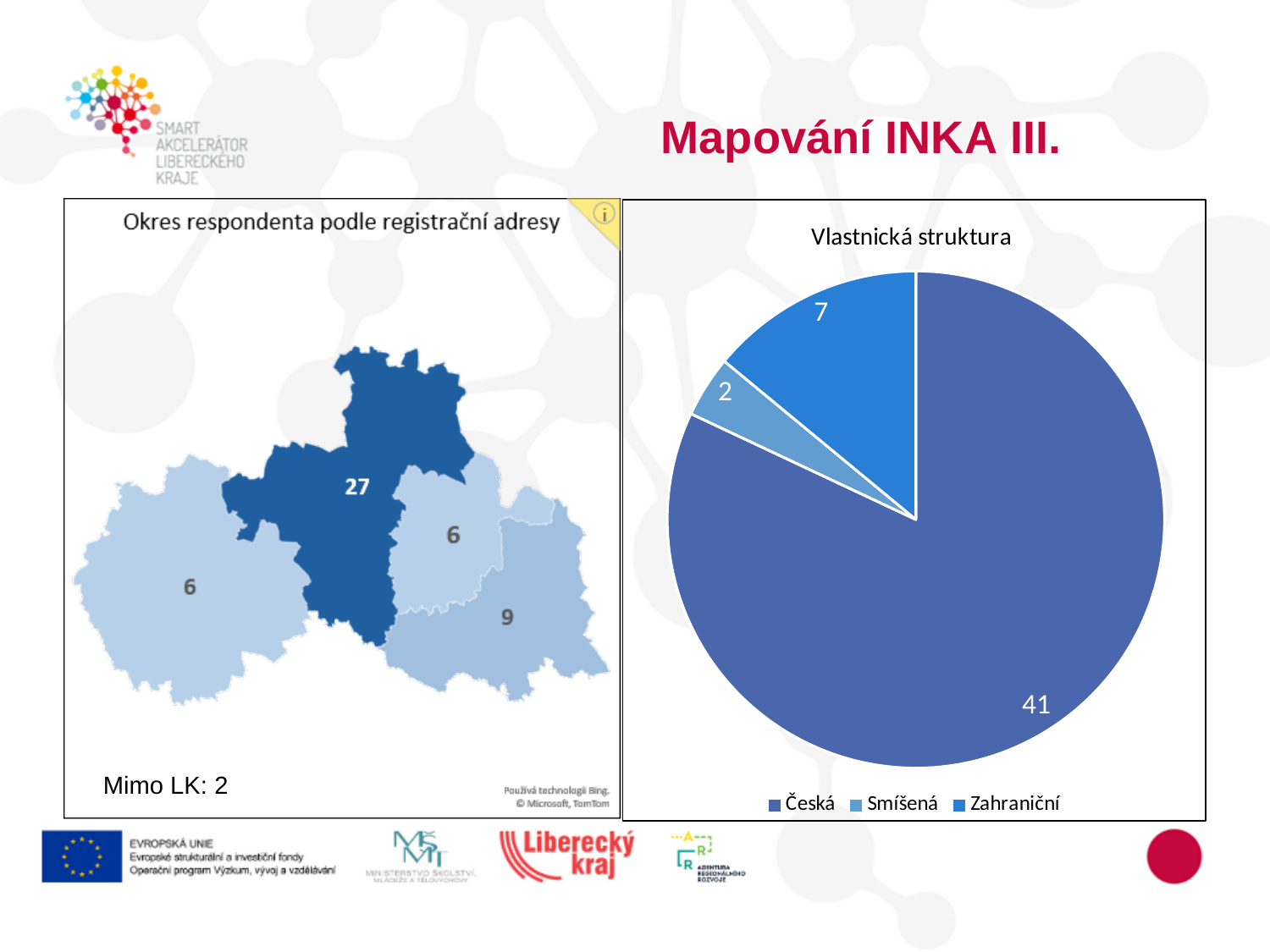
In the map chart 'Okres respondenta podle registrační adresy', what is the highest value shown for a district? 27 In the 'Vlastnická struktura' chart, what is the value for Smíšená? 2 In the 'Vlastnická struktura' chart, what is the difference between the values for Česká and Zahraniční? 34 In the 'Vlastnická struktura' chart, which category has the smallest slice? Smíšená In the 'Vlastnická struktura' chart, how many categories does the legend list? 3 In the 'Vlastnická struktura' chart, what is the value for Zahraniční? 7 In the 'Vlastnická struktura' chart, what share of the total does Česká represent? 82% In the map chart 'Okres respondenta podle registrační adresy', how many districts have a value label shown? 4 In the 'Vlastnická struktura' chart, what is the value for Česká? 41 In the map chart 'Okres respondenta podle registrační adresy', what value is given for 'Mimo LK'? 2 In the 'Vlastnická struktura' chart, which category has the largest slice? Česká In the 'Vlastnická struktura' chart, what kind of chart is shown? pie chart